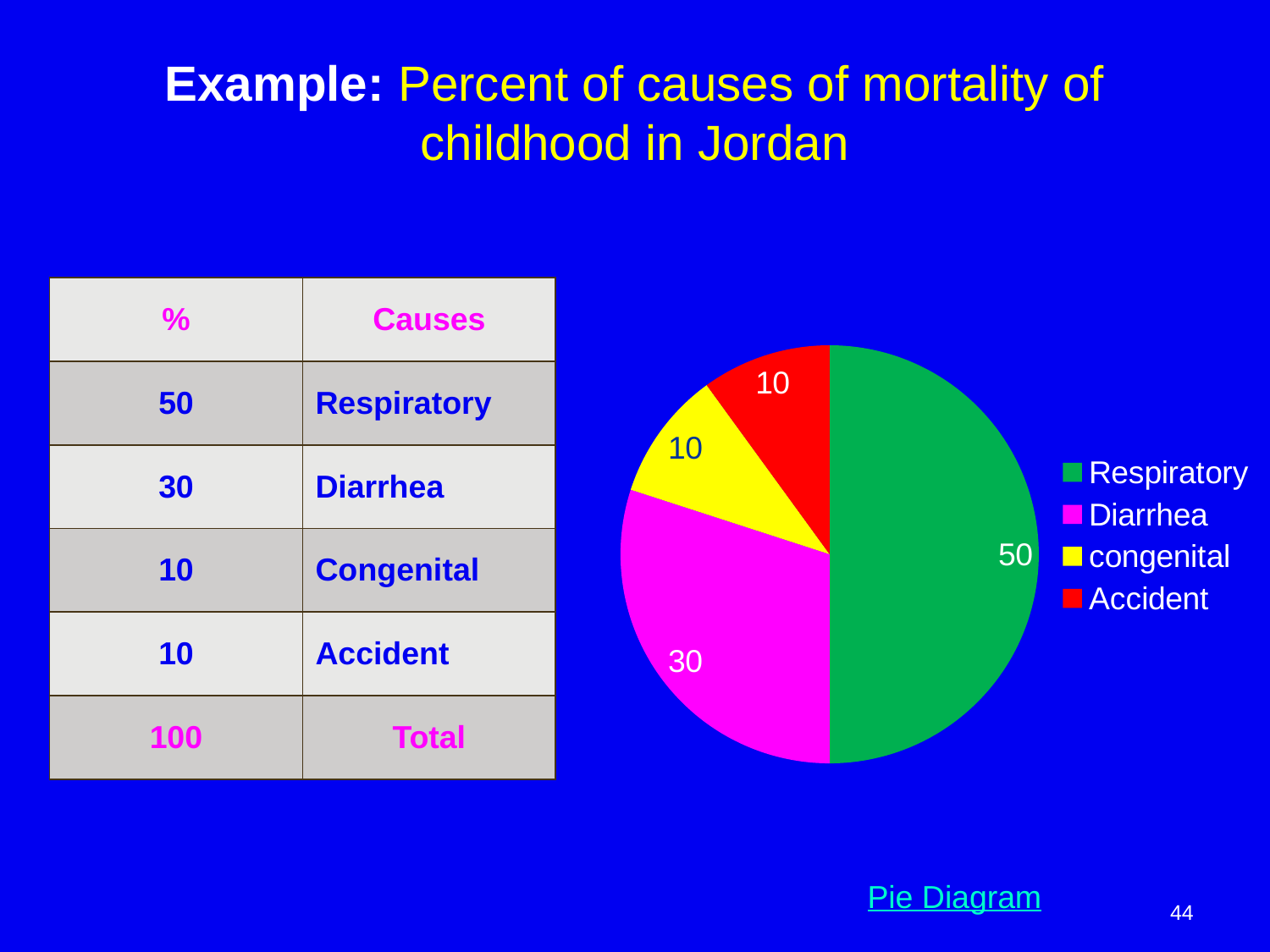
What share of the pie does the Respiratory slice represent? 50% Which is larger in the pie chart, Diarrhea or congenital? Diarrhea How many entries does the legend of the pie chart list? 4 Which legend entry is shown in green in the pie chart? Respiratory What is the value shown for Respiratory in the pie chart? 50 How many slices does the pie chart have? 4 Which cause has the largest slice in the pie chart? Respiratory What colour is the Diarrhea slice in the pie chart? magenta What kind of chart is shown on the slide? pie chart What is the difference between the Respiratory and Diarrhea values in the pie chart? 20 What is the value shown for Accident in the pie chart? 10 What is the value shown for Diarrhea in the pie chart? 30